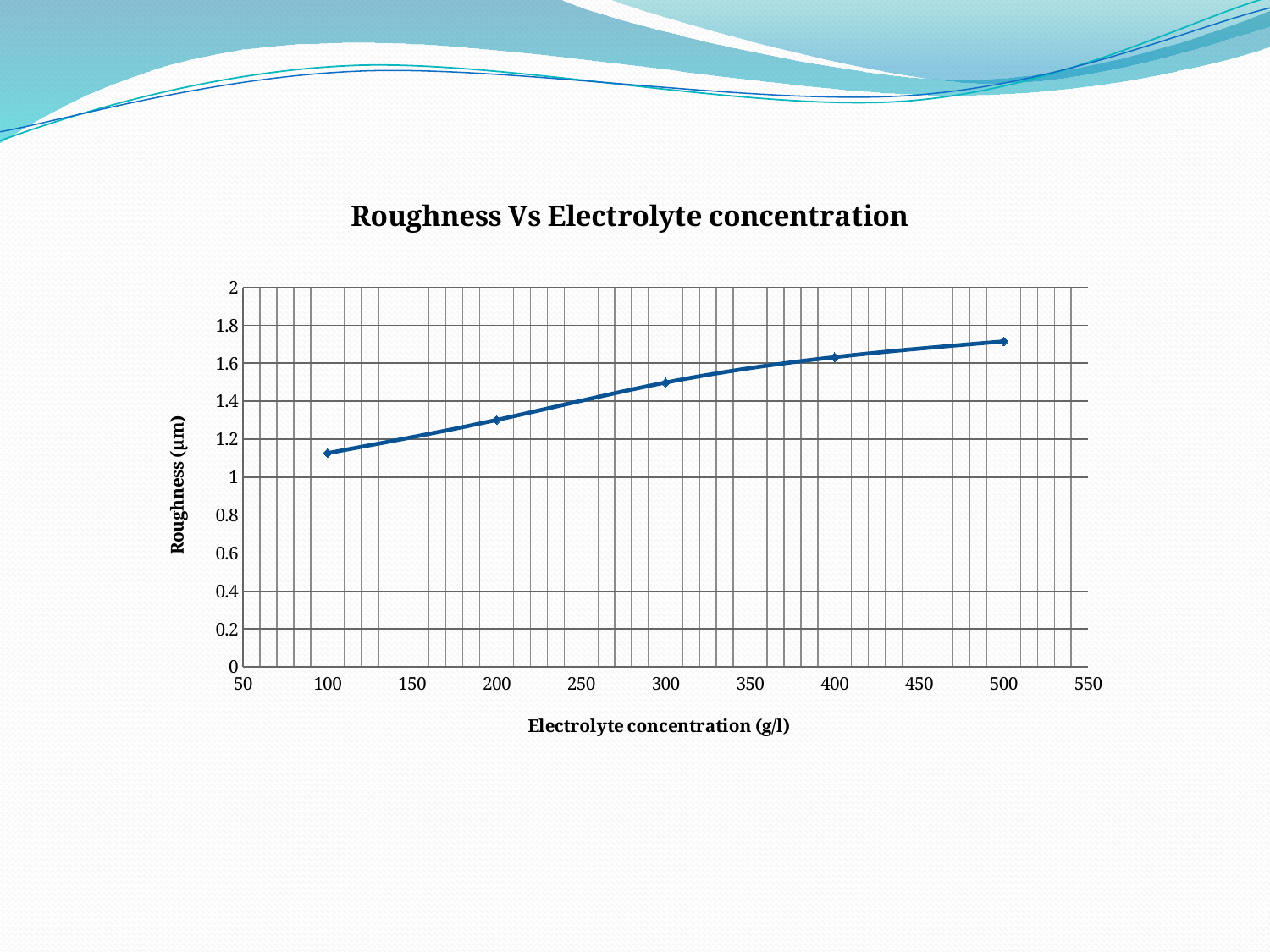
What kind of chart is shown on the slide? line chart Does roughness rise or fall as electrolyte concentration increases along the x axis? rise What is the label of the y axis? Roughness (µm) Is the roughness value at electrolyte concentration 100 greater or less than 1? greater Is the roughness value at electrolyte concentration 200 greater or less than 1.4? less How many data points are plotted on the line? 5 Which has the larger roughness value: electrolyte concentration 200 or 400? 400 At which electrolyte concentration is the roughness highest? 500 Is the roughness value at electrolyte concentration 400 greater or less than 1.4? greater At which electrolyte concentration is the roughness lowest? 100 What is the title of the chart? Roughness Vs Electrolyte concentration